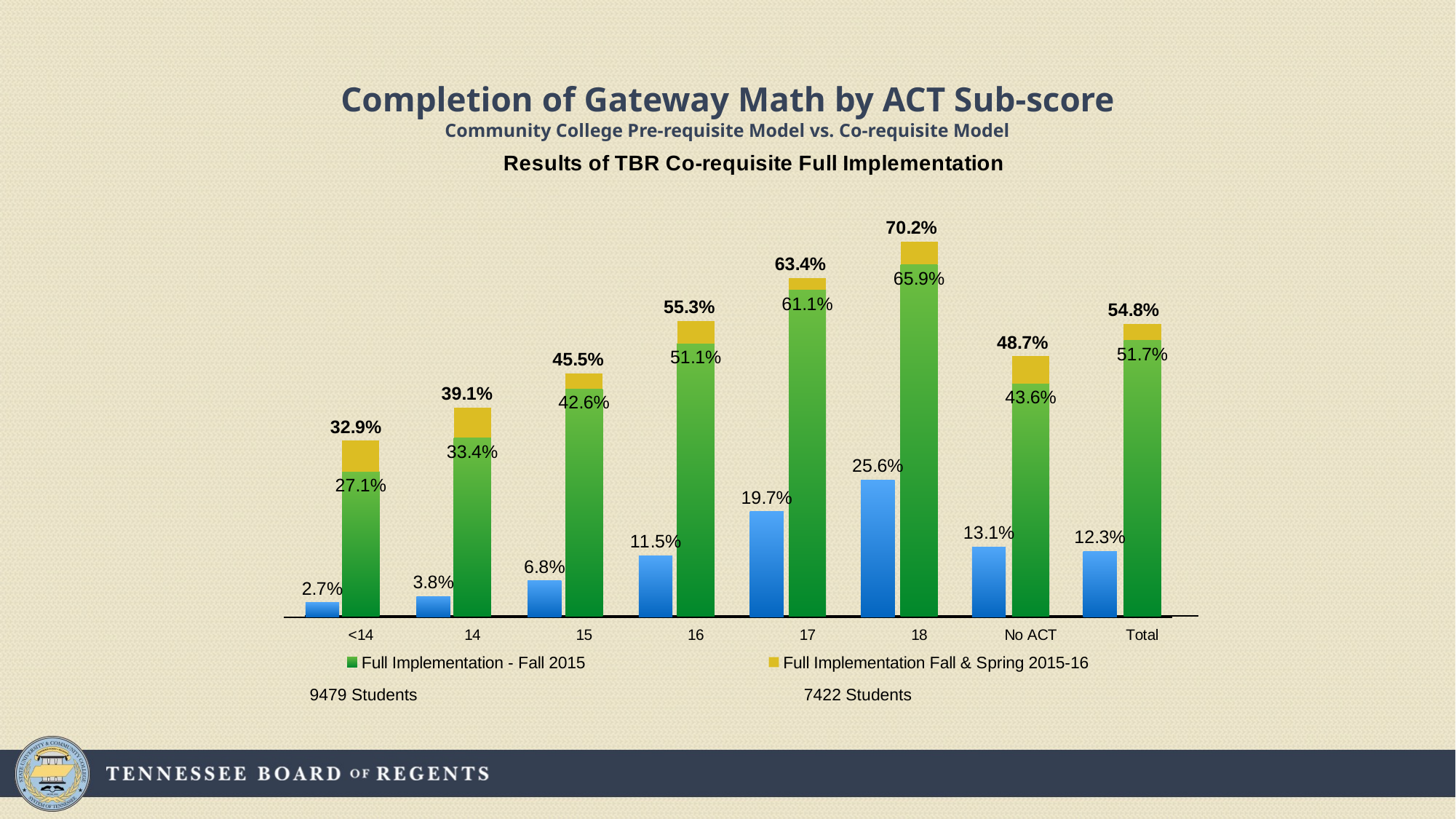
What is the Full Implementation - Fall 2015 value for ACT sub-score 18? 65.9% What kind of chart is shown on the slide? Bar chart Which category has the highest Full Implementation Fall & Spring 2015-16 value? 18 What is the Full Implementation Fall & Spring 2015-16 value for the Total category? 54.8% How many series does the legend list? 2 What is the Full Implementation - Fall 2015 value for ACT sub-score 15? 42.6% Which is larger: the Full Implementation - Fall 2015 value for ACT sub-score 17 or for No ACT? 17 What is the difference between the Full Implementation Fall & Spring 2015-16 value and the Full Implementation - Fall 2015 value for ACT sub-score 16? 4.2% Do the blue bar values rise or fall from <14 to 18? Rise What is the value of the blue bar for the No ACT category? 13.1% How many categories are shown on the x axis? 8 Which category has the lowest blue bar value? <14